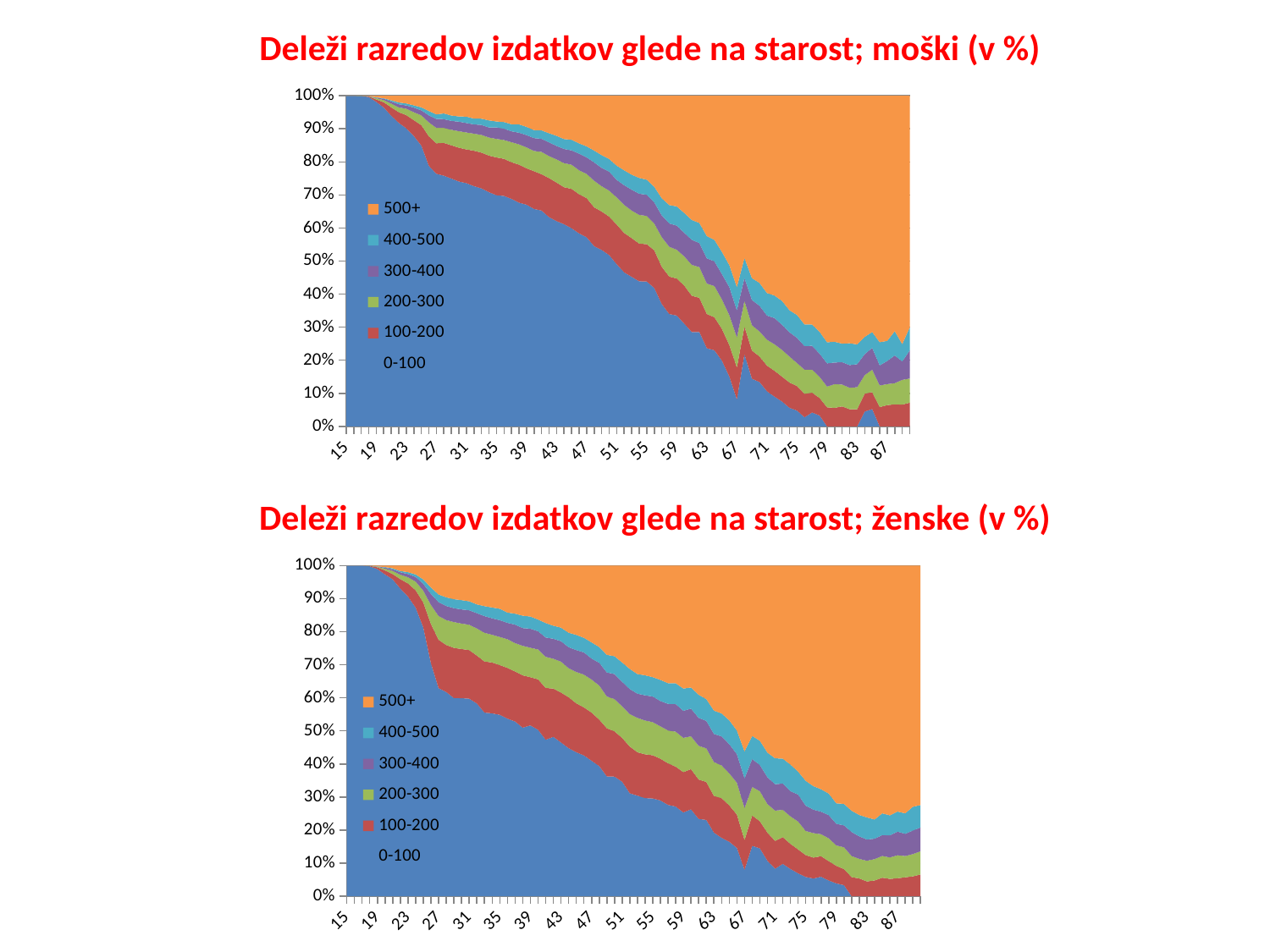
In the bottom chart (ženske), is the share of the 0-100 class at age 55 greater or less than 50%? less How many series does the legend of the bottom chart (ženske) list? 6 In the top chart (moški), does the share of the 0-100 class rise or fall as age increases along the x axis? fall In the bottom chart (ženske), is the share of the 0-100 class at age 15 greater or less than 90%? greater What kind of chart is the top chart, 'Deleži razredov izdatkov glede na starost; moški (v %)'? stacked area chart In the top chart (moški), which colour represents the 500+ class? orange How many series does the legend of the top chart (moški) list? 6 In the top chart (moški), is the share of the 0-100 class at age 87 greater or less than 10%? less How many age labels are shown on the x axis of the top chart (moški)? 19 What is the title of the bottom chart? Deleži razredov izdatkov glede na starost; ženske (v %) In the bottom chart (ženske), does the share of the 500+ class rise or fall as age increases along the x axis? rise